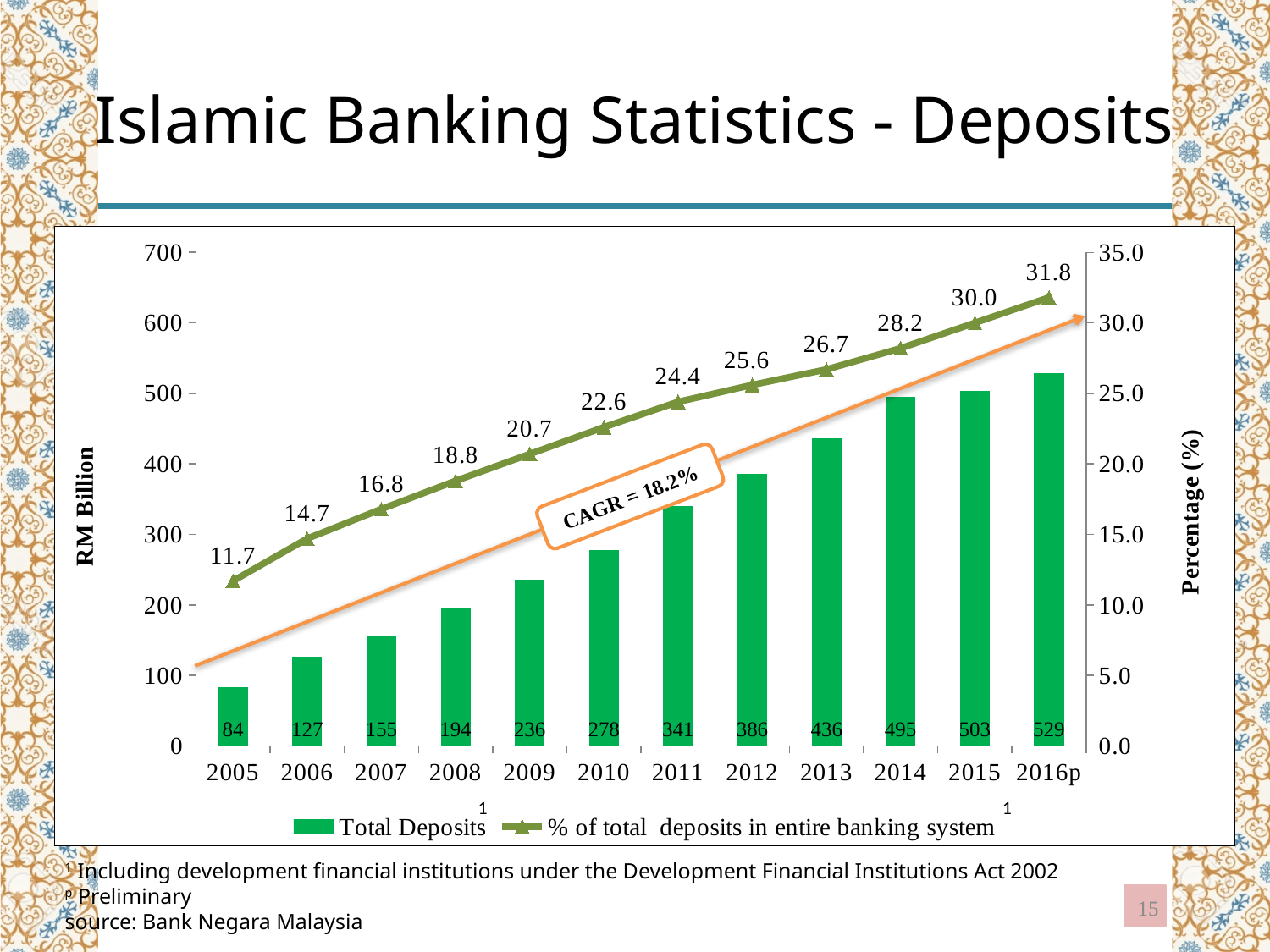
Which year has the lowest percentage of total deposits in the entire banking system? 2005 Does the percentage of total deposits in the entire banking system rise or fall from 2005 to 2016p? rise What is the value of Total Deposits for 2010? 278 Which year has the highest Total Deposits? 2016p How many series does the legend list? 2 How many years are shown on the x axis? 12 What percentage of total deposits in the entire banking system is shown for 2013? 26.7 Is the Total Deposits value for 2009 greater or less than 200? greater What is the difference in Total Deposits between 2014 and 2013? 59 What CAGR is stated on the chart? 18.2% What kind of chart is used to show Total Deposits? bar chart Which is larger, Total Deposits in 2011 or in 2012? 2012